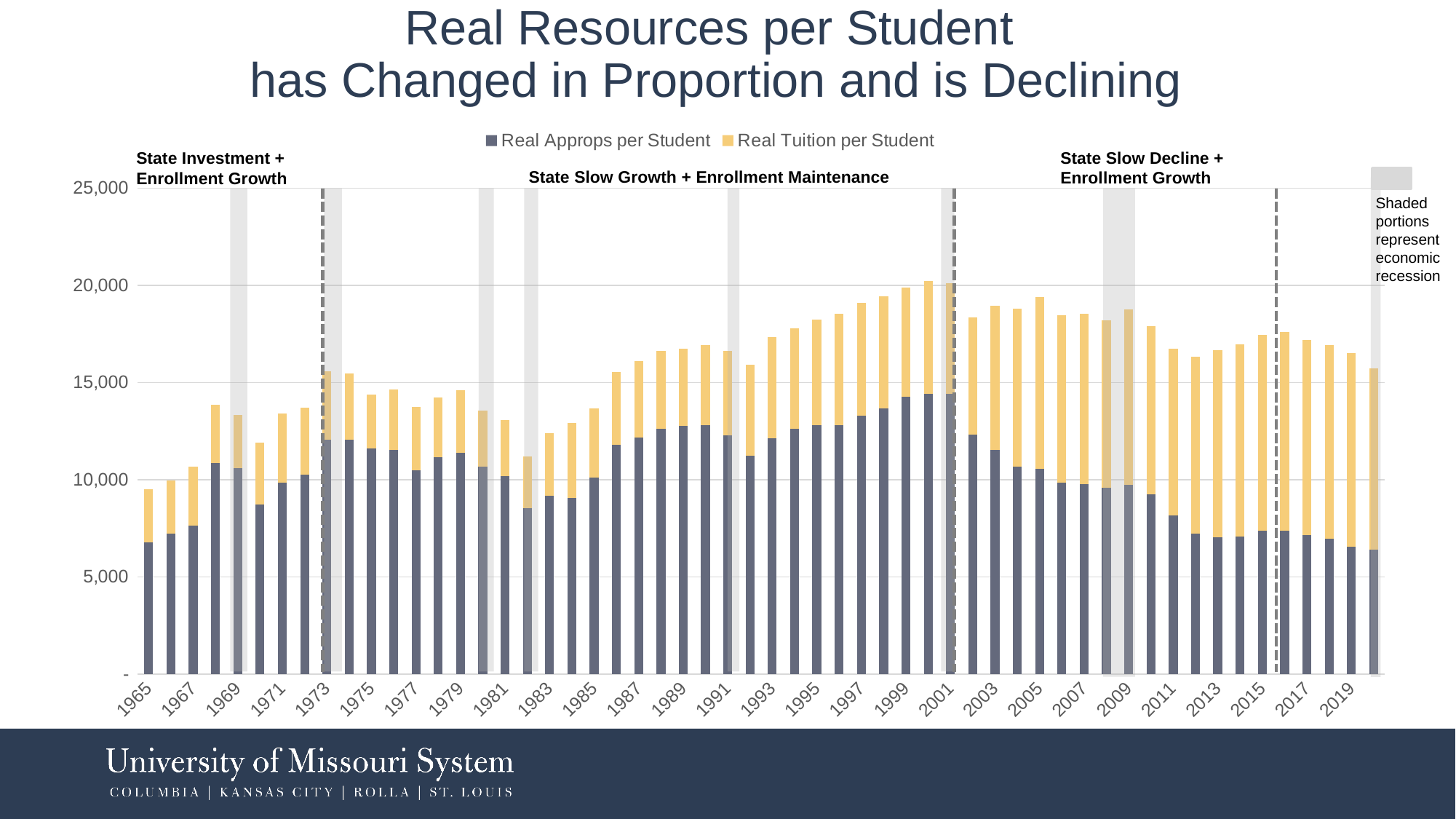
Which year has the taller total stacked bar, 1965 or 1999? 1999 Is the total height of the stacked bar for 2019 greater or less than 15,000? greater Which year has the larger Real Approps per Student value, 2001 or 2019? 2001 Is the value of Real Approps per Student in 1965 greater or less than 10,000? less What are the two series named in the legend? Real Approps per Student and Real Tuition per Student According to the note on the right, what do the shaded portions of the chart represent? Economic recession Does Real Approps per Student generally rise or fall from 2001 to 2019? Fall Is the value of Real Approps per Student in 2019 greater or less than 10,000? less What kind of chart is shown on the slide? Stacked bar chart How many series does the legend list? 2